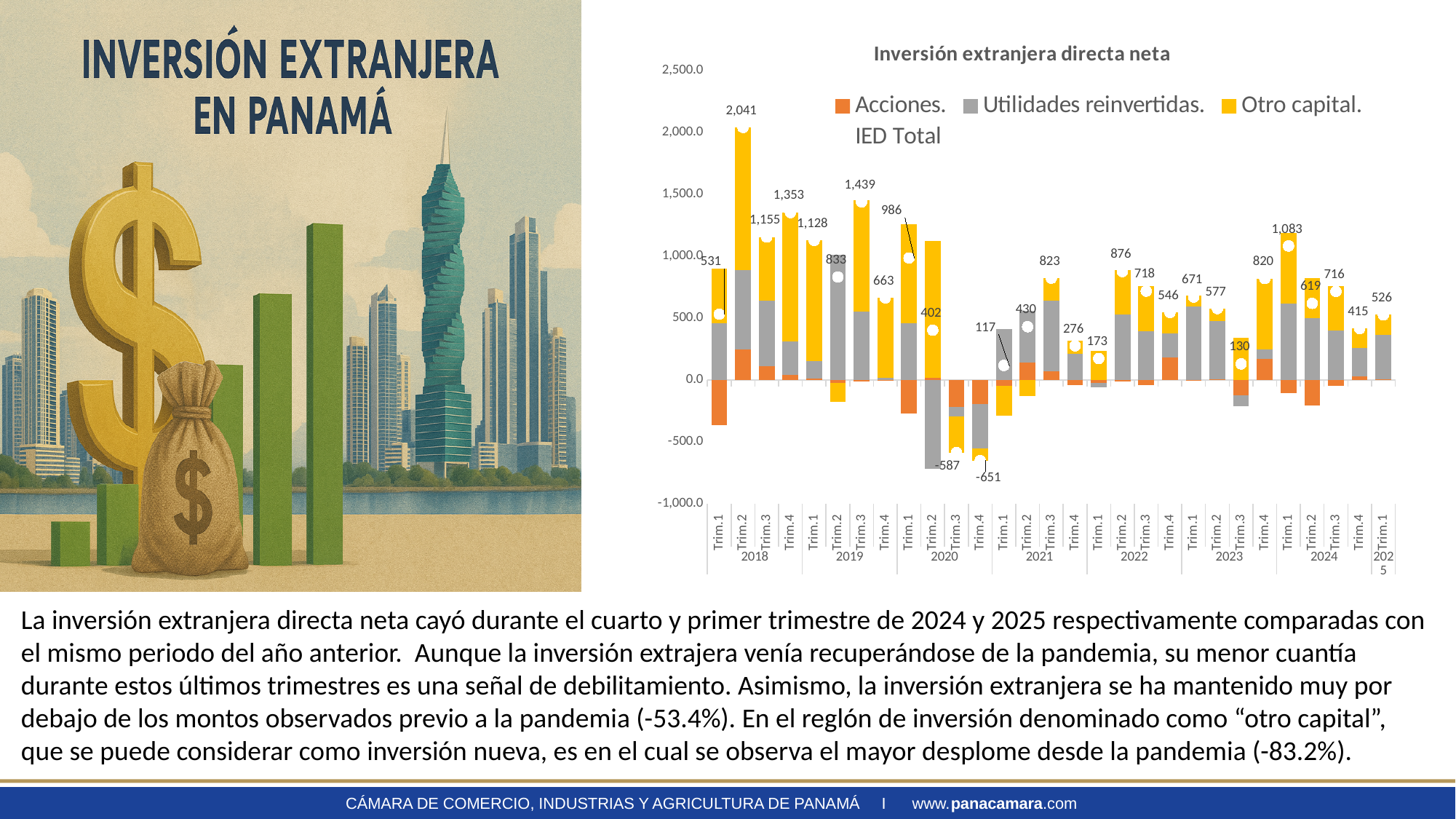
Which is larger, the IED Total for Trim.3 2019 or Trim.3 2024? Trim.3 2019 What is the IED Total value for Trim.4 2020? -651 What type of chart is shown? Combination chart: stacked bars with a line (markers) for IED Total What is the title of the chart? Inversión extranjera directa neta What is the IED Total value for Trim.1 2024? 1,083 Which colour represents 'Otro capital.' in the chart? Yellow What is the IED Total value for Trim.2 2018? 2,041 What is the IED Total value for Trim.1 2025? 526 Which quarter has the lowest IED Total value? Trim.4 2020 What is the difference between the IED Total for Trim.1 2024 and Trim.2 2024? 464 Which quarter has the highest IED Total value? Trim.2 2018 How many series does the legend list? 4